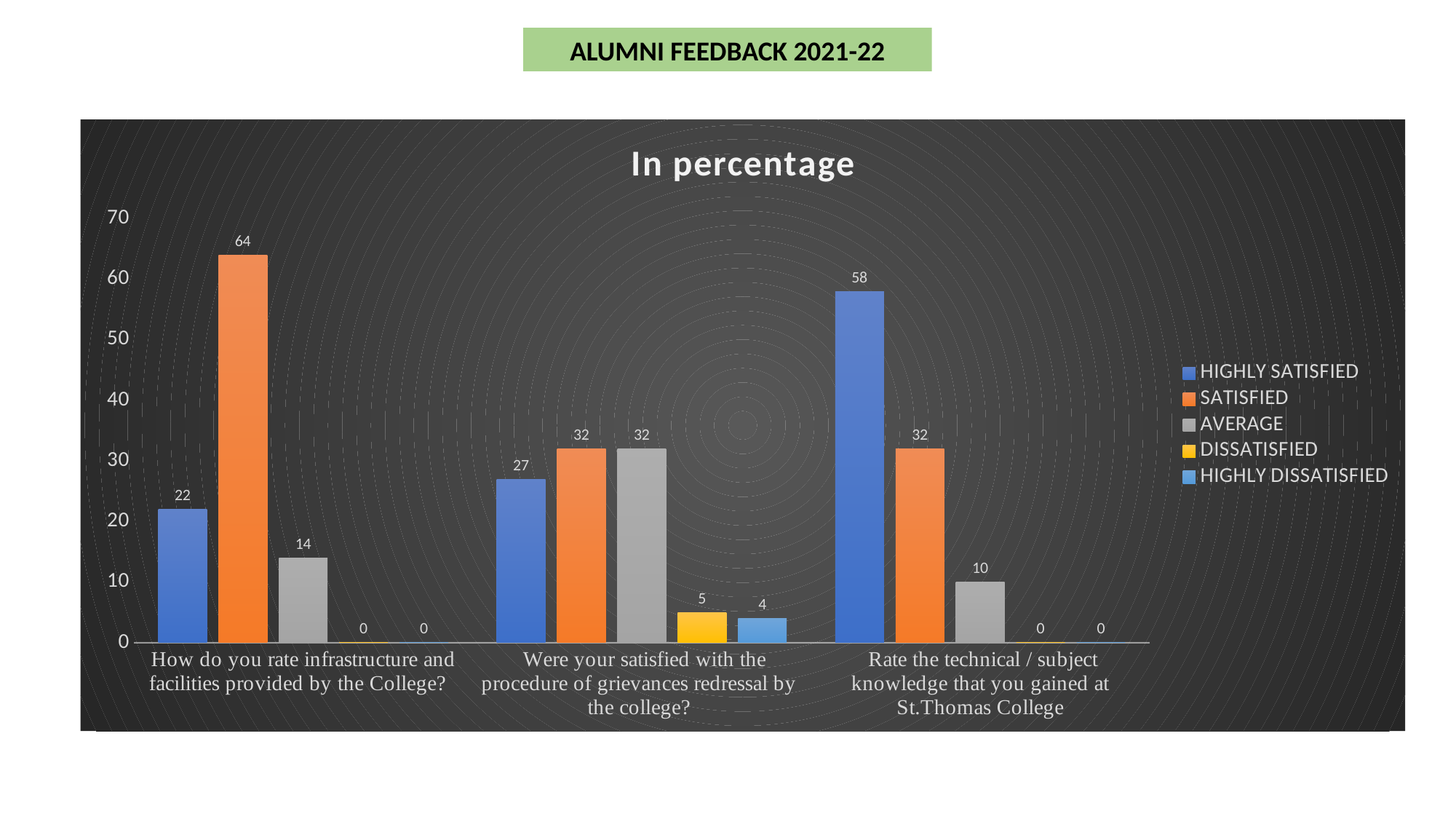
How many categories are shown on the x axis? 3 What kind of chart is shown on the slide? Bar chart What is the title of the chart? In percentage Which category has the highest HIGHLY SATISFIED value? Rate the technical / subject knowledge that you gained at St.Thomas College What is the DISSATISFIED value for "Were your satisfied with the procedure of grievances redressal by the college?"? 5 What is the AVERAGE value for "How do you rate infrastructure and facilities provided by the College?"? 14 What is the HIGHLY SATISFIED value for "Rate the technical / subject knowledge that you gained at St.Thomas College"? 58 Which is larger for "Rate the technical / subject knowledge that you gained at St.Thomas College": HIGHLY SATISFIED or SATISFIED? HIGHLY SATISFIED What is the SATISFIED value for "How do you rate infrastructure and facilities provided by the College?"? 64 Which category has the lowest AVERAGE value? Rate the technical / subject knowledge that you gained at St.Thomas College How many series does the legend list? 5 What is the difference between the SATISFIED and HIGHLY SATISFIED values for "How do you rate infrastructure and facilities provided by the College?"? 42